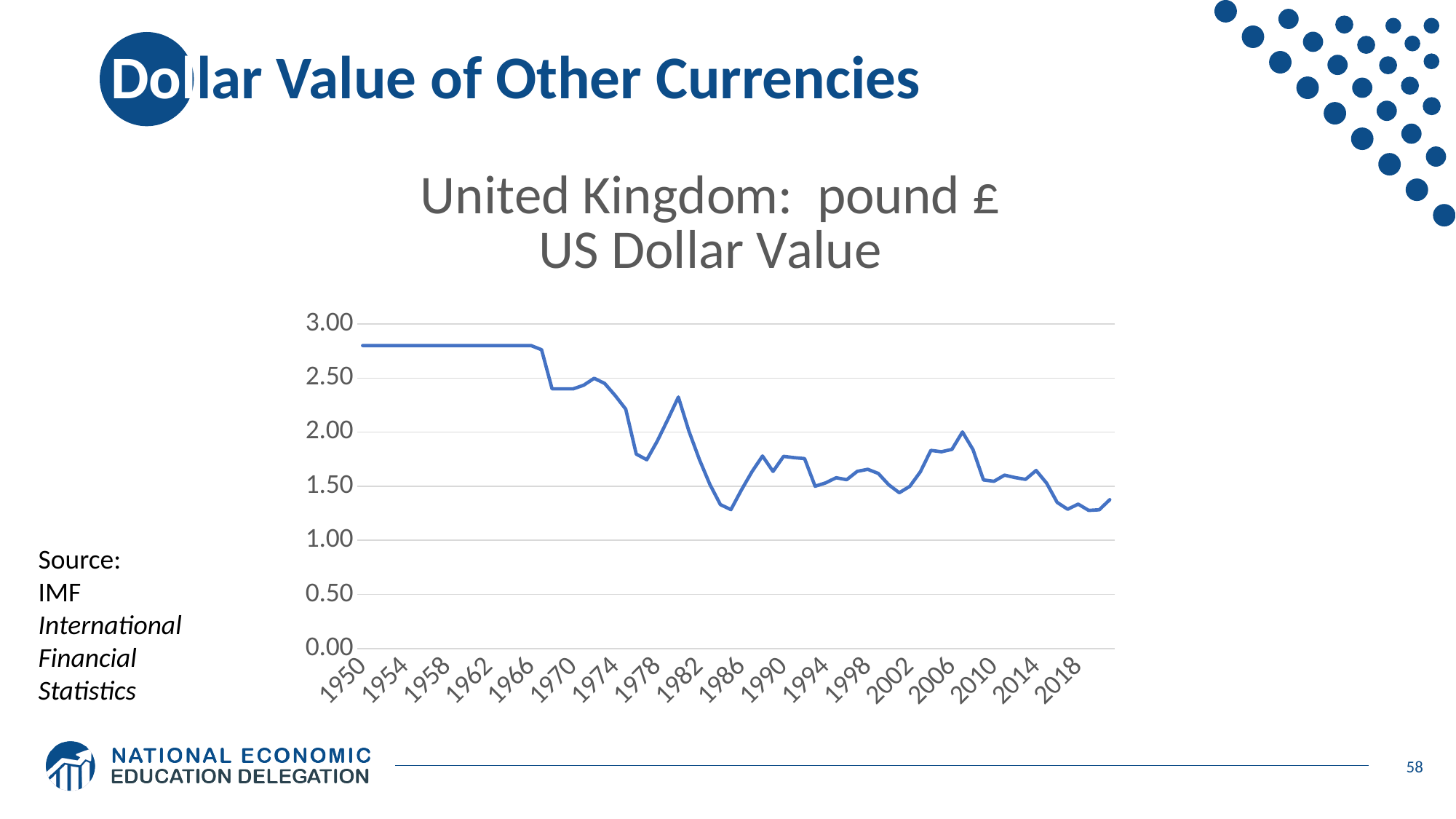
Is the value for 1982 greater or less than 2.00? less Is the value for 1950 greater or less than 2.50? greater Is the value for 1970 greater or less than 2.00? greater What is the highest value shown on the vertical axis? 3.00 What kind of chart is shown on the slide? line chart Which year has the larger value, 1970 or 1986? 1970 Which year has the larger value, 1950 or 2018? 1950 What is the title of the chart? United Kingdom: pound £ US Dollar Value Overall, do the values rise or fall from 1950 to 2018? fall